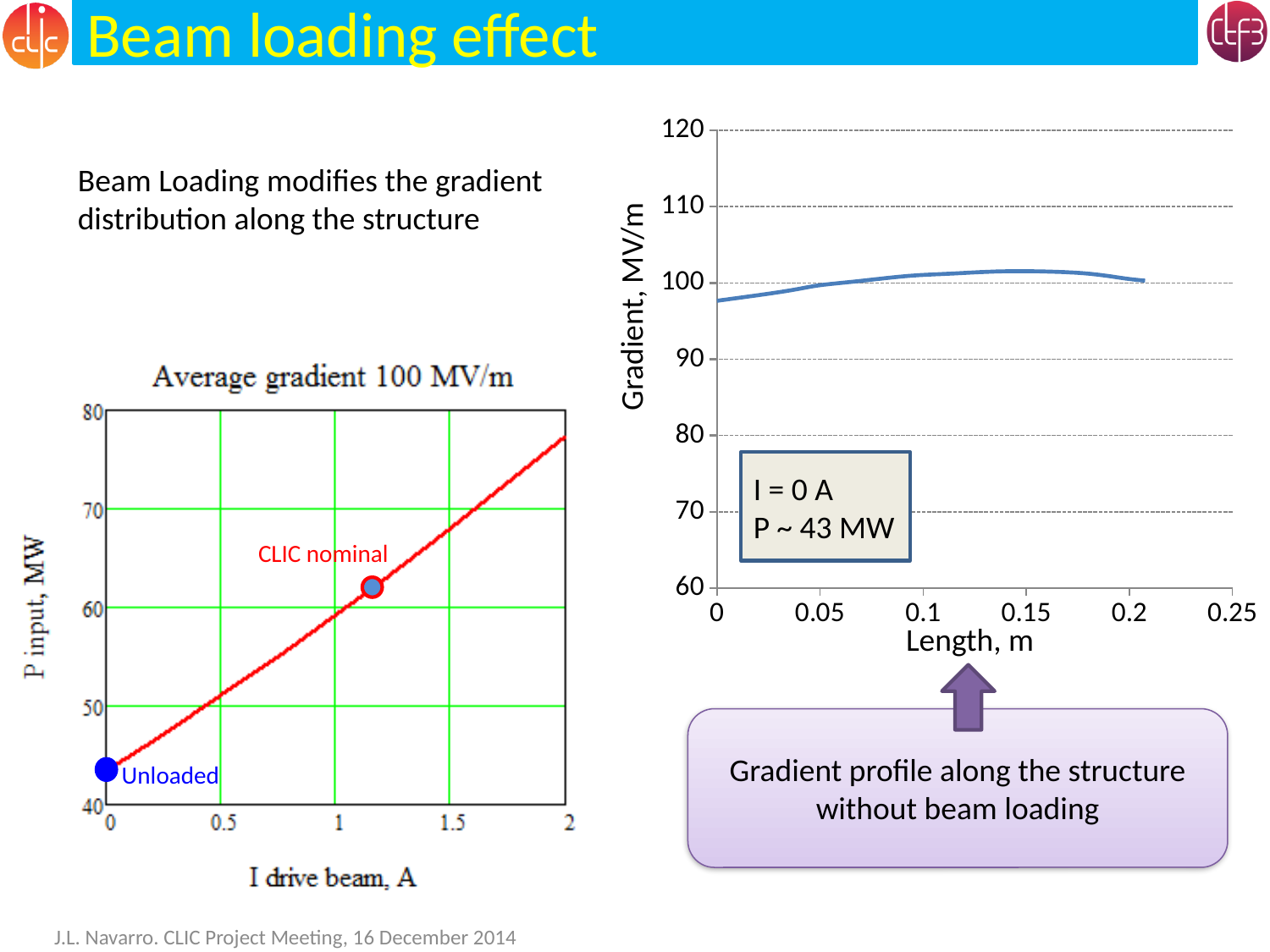
In the chart titled "Average gradient 100 MV/m", does P input rise or fall as I drive beam increases? rise What is the x-axis label of the chart titled "Average gradient 100 MV/m"? I drive beam, A In the chart titled "Average gradient 100 MV/m", is the P input value at I drive beam = 2 A greater or less than 70? greater What kind of chart is the chart titled "Average gradient 100 MV/m"? line chart In the chart titled "Average gradient 100 MV/m", is the P input value at the "CLIC nominal" point greater or less than 60? greater In the chart titled "Average gradient 100 MV/m", which point has the larger P input: "CLIC nominal" or "Unloaded"? CLIC nominal In the chart on the right of the slide, is the gradient at Length = 0 m greater or less than 100? less What is the y-axis label of the chart on the right of the slide? Gradient, MV/m What kind of chart is the chart on the right of the slide (Gradient vs Length)? line chart